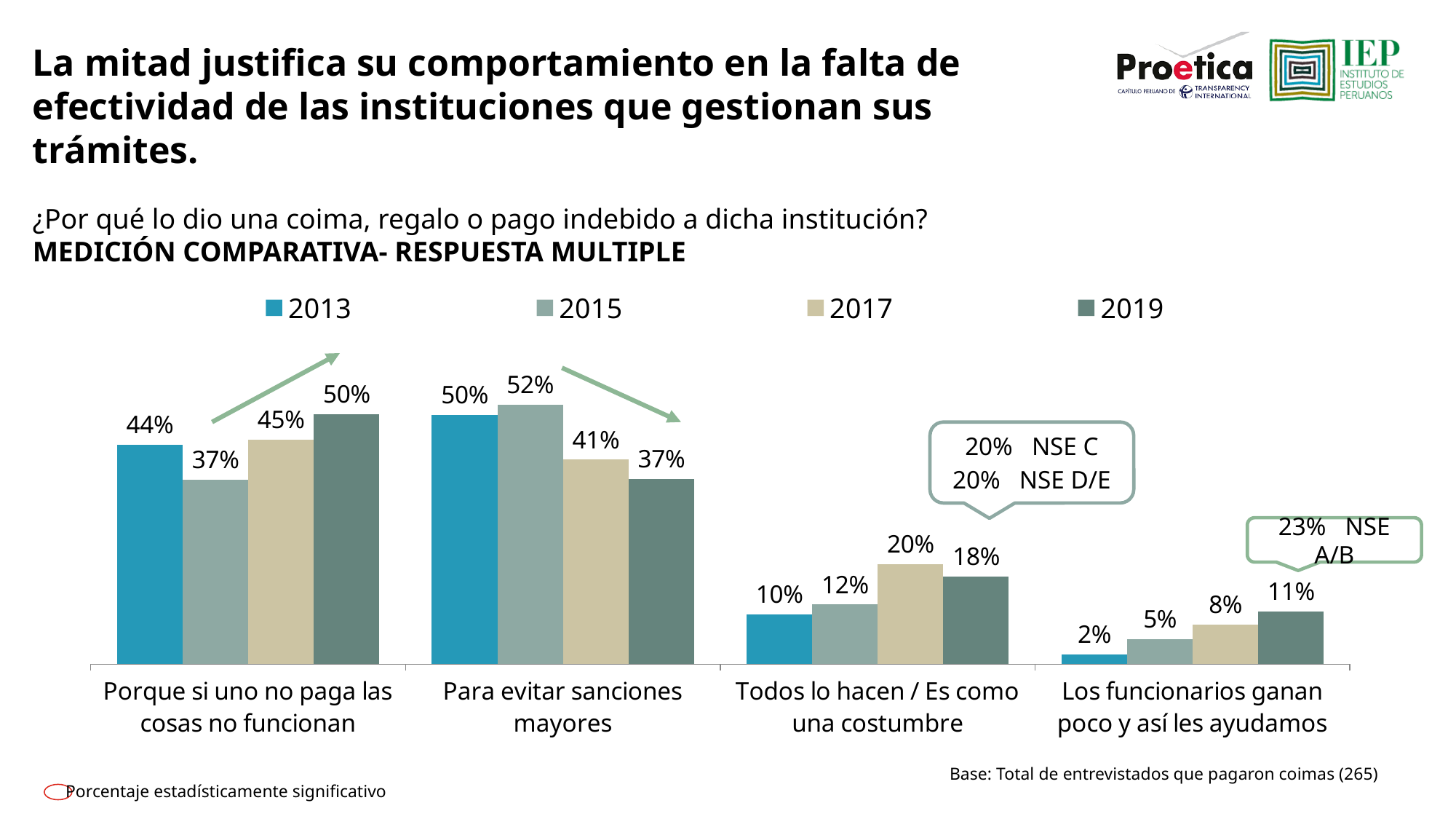
What is the difference between the 2013 and 2019 values for "Para evitar sanciones mayores"? 13% How many series does the legend list? 4 How many categories are shown on the x axis? 4 For "Porque si uno no paga las cosas no funcionan", which is larger: the 2013 value or the 2015 value? 2013 What kind of chart is shown on the slide? Bar chart Which category has the lowest 2019 value? Los funcionarios ganan poco y así les ayudamos Which category has the highest 2015 value? Para evitar sanciones mayores What is the 2017 value for "Todos lo hacen / Es como una costumbre"? 20% What is the 2013 value for "Los funcionarios ganan poco y así les ayudamos"? 2% What is the 2015 value for "Para evitar sanciones mayores"? 52% What is the 2019 value for "Porque si uno no paga las cosas no funcionan"? 50% Do the values for "Los funcionarios ganan poco y así les ayudamos" rise or fall from 2013 to 2019? Rise